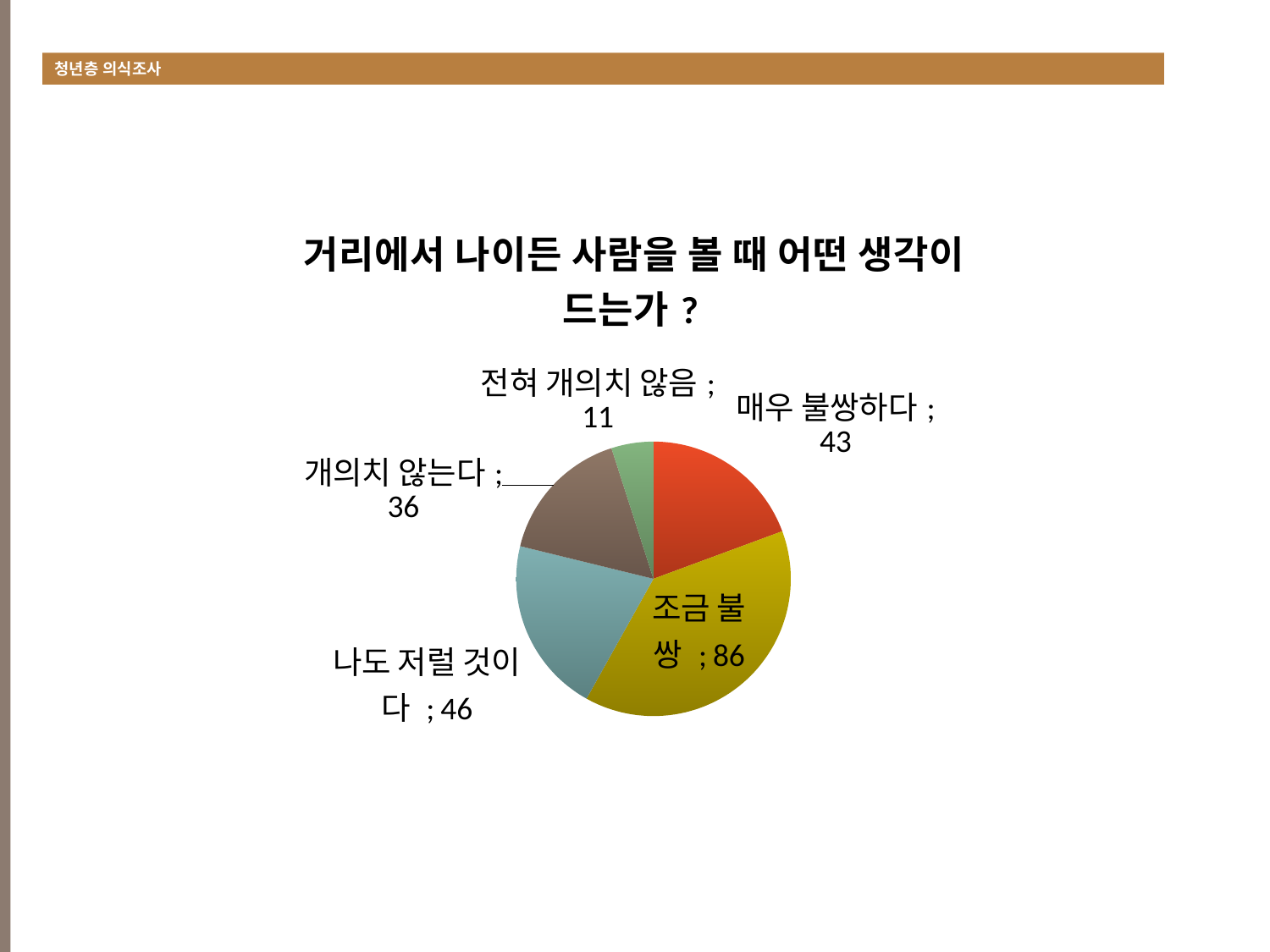
What is the difference between the values for 조금 불쌍 and 개의치 않는다? 50 What is the value for 조금 불쌍? 86 What is the value for 매우 불쌍하다? 43 Which category has the smallest slice? 전혀 개의치 않음 Which is larger, 나도 저럴 것이다 or 매우 불쌍하다? 나도 저럴 것이다 How many categories are shown in the pie chart? 5 What kind of chart is shown on the slide? pie chart What is the value for 나도 저럴 것이다? 46 Which category has the largest slice? 조금 불쌍 What is the value for 전혀 개의치 않음? 11 What is the title of the chart? 거리에서 나이든 사람을 볼 때 어떤 생각이 드는가 ? What is the total of all the slice values in the pie chart? 222